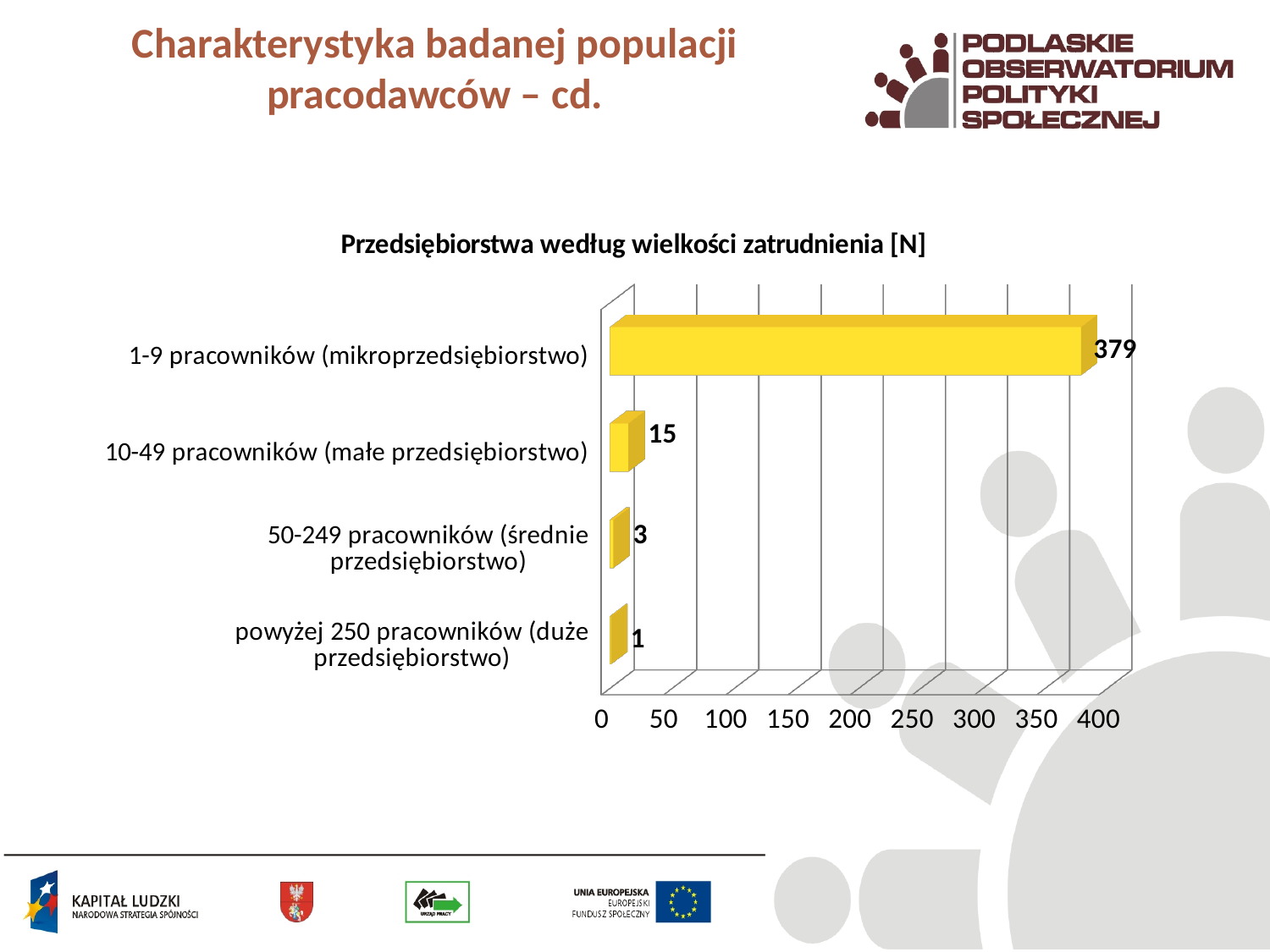
What is the difference between the values for 1-9 pracowników (mikroprzedsiębiorstwo) and 10-49 pracowników (małe przedsiębiorstwo)? 364 What is the value for 1-9 pracowników (mikroprzedsiębiorstwo)? 379 How many categories are shown in the chart? 4 What is the difference between the values for 10-49 pracowników (małe przedsiębiorstwo) and 50-249 pracowników (średnie przedsiębiorstwo)? 12 Which is larger: the value for 50-249 pracowników (średnie przedsiębiorstwo) or powyżej 250 pracowników (duże przedsiębiorstwo)? 50-249 pracowników (średnie przedsiębiorstwo) What is the title of the chart? Przedsiębiorstwa według wielkości zatrudnienia [N] What kind of chart is shown on the slide? bar chart What is the value for 10-49 pracowników (małe przedsiębiorstwo)? 15 Which category has the lowest value? powyżej 250 pracowników (duże przedsiębiorstwo) What is the value for powyżej 250 pracowników (duże przedsiębiorstwo)? 1 What is the value for 50-249 pracowników (średnie przedsiębiorstwo)? 3 Which category has the highest value? 1-9 pracowników (mikroprzedsiębiorstwo)